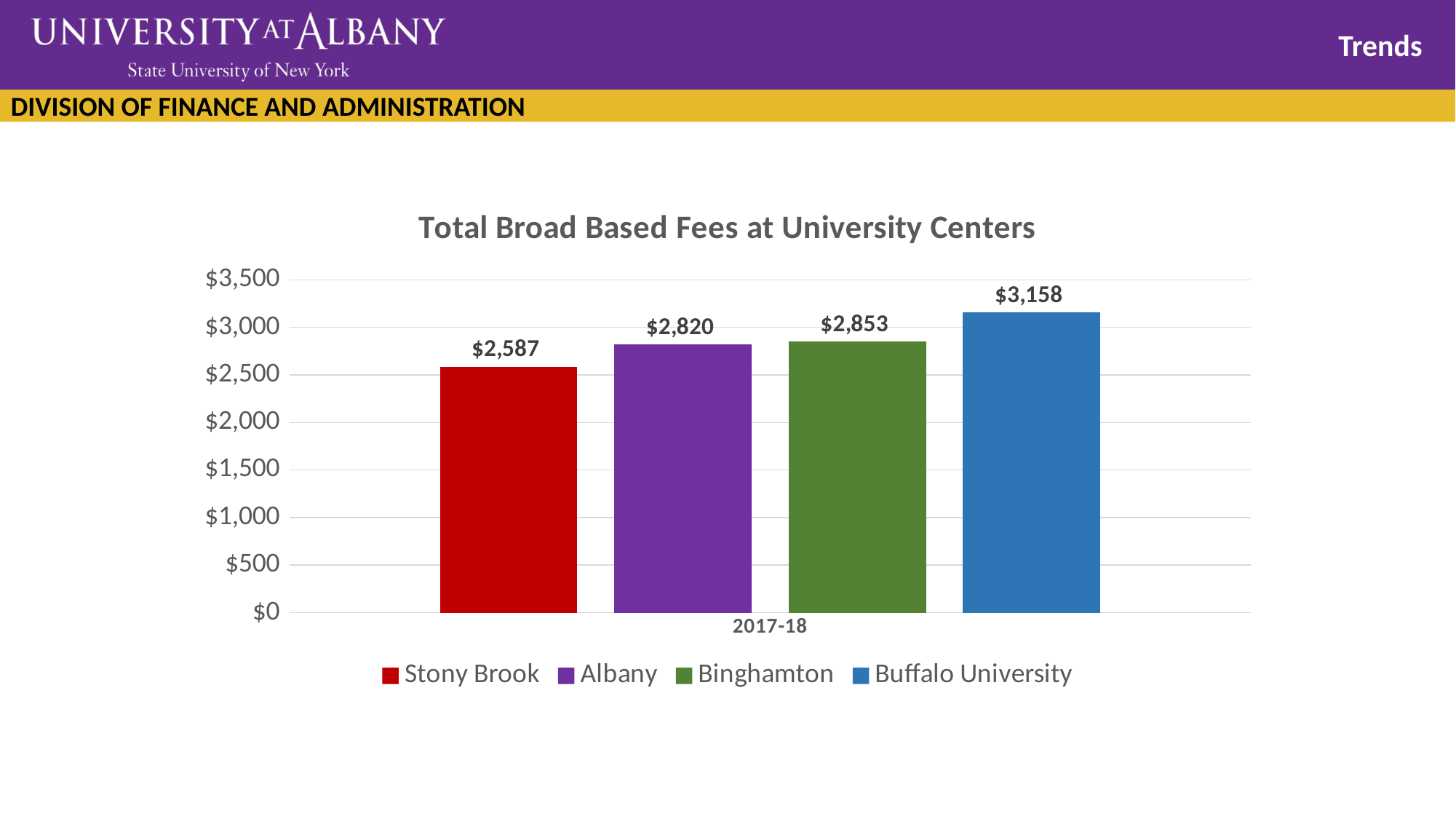
Which university center has the highest total broad based fee? Buffalo University What is the title of the chart? Total Broad Based Fees at University Centers What is the total broad based fee for Binghamton in 2017-18? $2,853 How many series does the legend list? 4 What kind of chart is shown on the slide? Bar chart What is the total broad based fee for Buffalo University in 2017-18? $3,158 What is the total broad based fee for Albany in 2017-18? $2,820 What is the difference between the fees for Buffalo University and Stony Brook? $571 Which university center has the lowest total broad based fee? Stony Brook What is the difference between the fees for Binghamton and Albany? $33 What is the total broad based fee for Stony Brook in 2017-18? $2,587 Which has a higher total broad based fee, Albany or Stony Brook? Albany